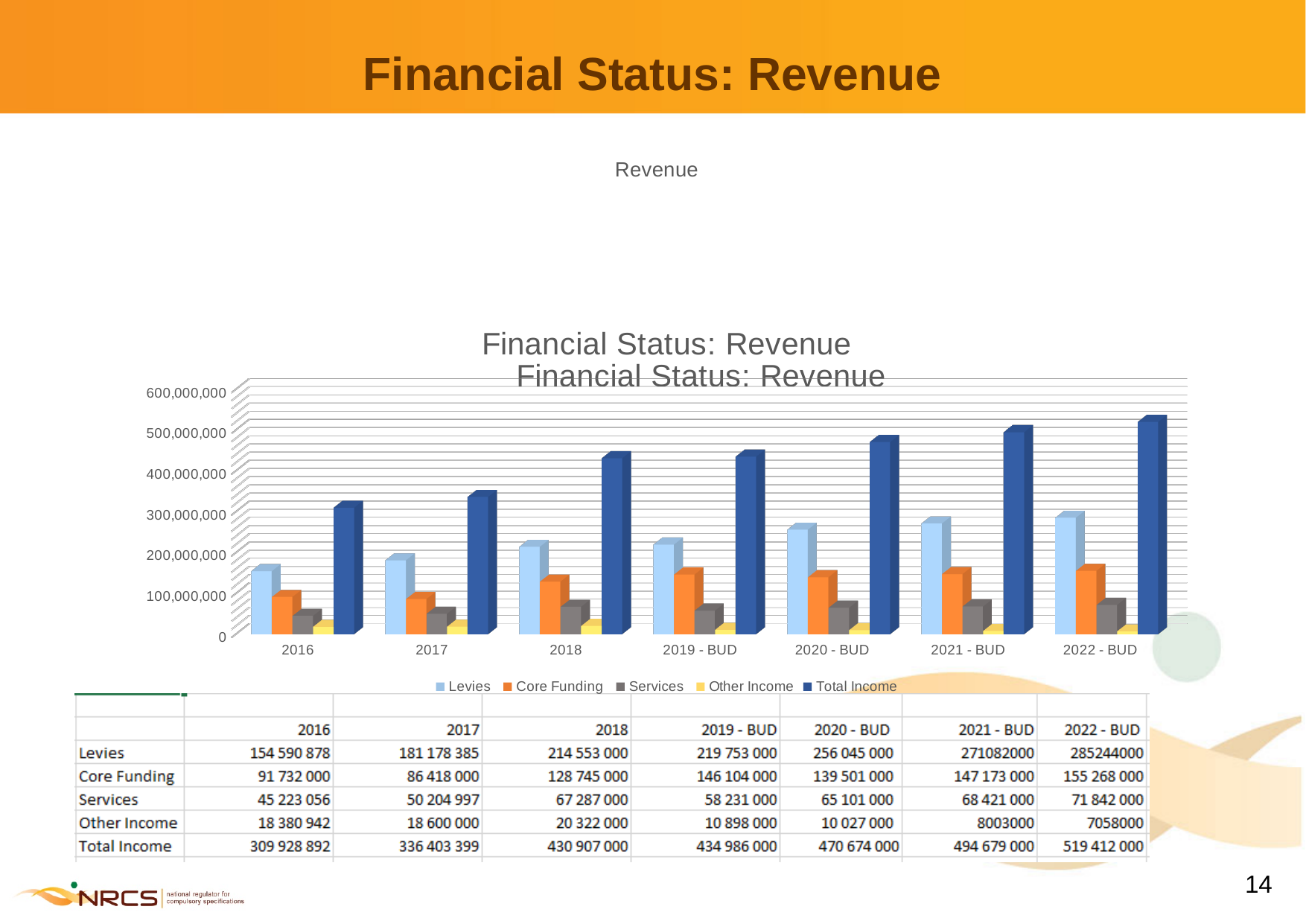
What is the difference in Total Income between 2022 - BUD and 2021 - BUD? 24 733 000 In which year is the Levies value lowest? 2016 What kind of chart is shown on the slide? bar chart Does Total Income rise or fall from 2016 to 2022 - BUD? rise Is the Total Income value for 2018 greater or less than 400,000,000? greater What is the Total Income value for 2016? 309 928 892 In which year is Total Income highest? 2022 - BUD What is the Levies value for 2018? 214 553 000 How many series does the chart legend list? 5 What is the Core Funding value for 2019 - BUD? 146 104 000 How many years are shown on the x axis of the chart? 7 Which year has the larger Services value, 2018 or 2019 - BUD? 2018